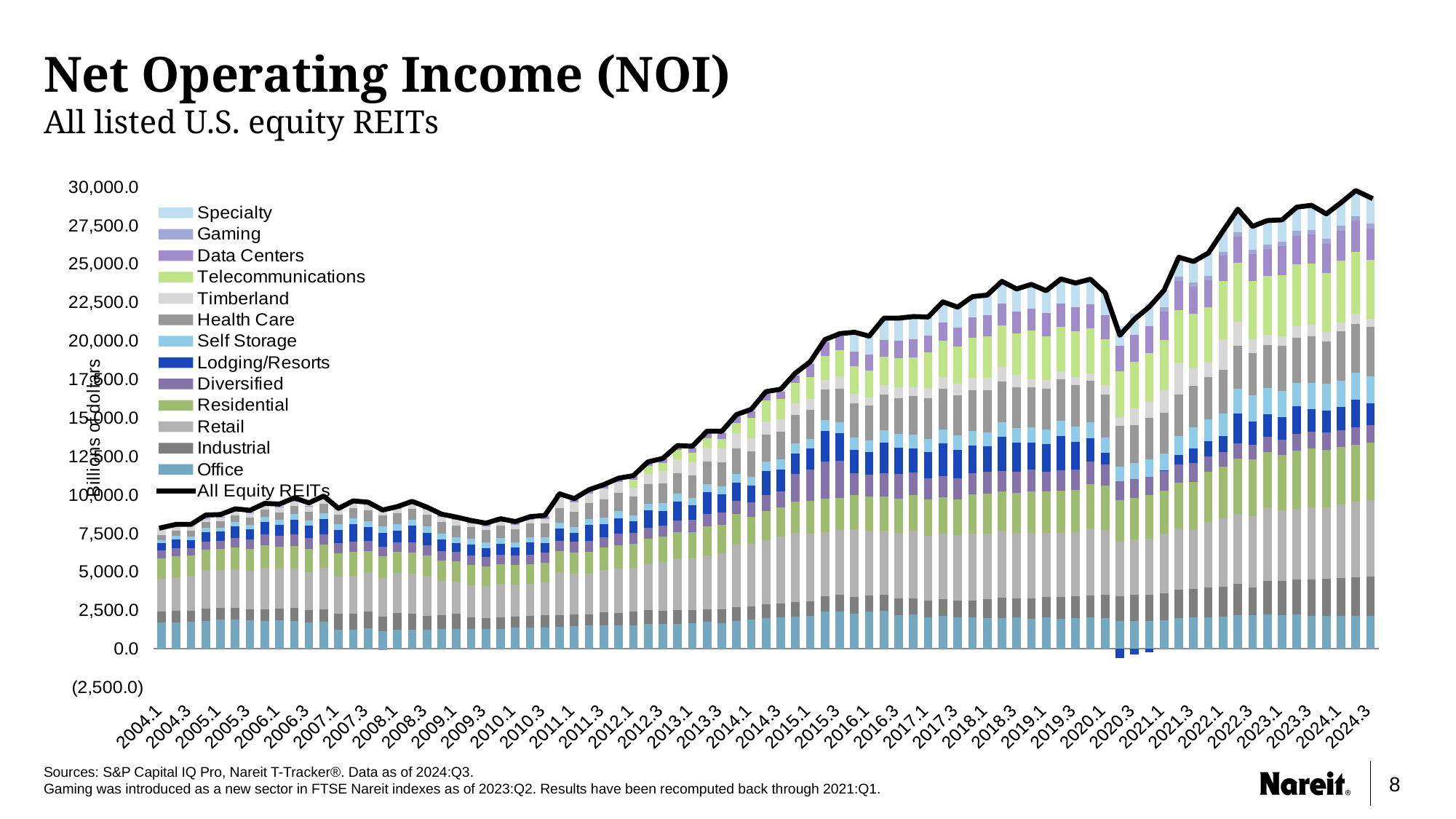
Which is larger, the All Equity REITs value for 2022.3 or for 2020.3? 2022.3 Is the value for Lodging/Resorts in 2020.3 greater or less than 0? less How many entries does the legend list? 14 What kind of chart is shown on the slide? Stacked bar chart with a line overlay Is the All Equity REITs value for 2024.3 greater or less than 27,500? greater What is the title of the chart on the slide? Net Operating Income (NOI) Is the All Equity REITs value for 2004.1 greater or less than 10,000? less Which is larger, the All Equity REITs value for 2015.3 or for 2009.3? 2015.3 What is the label on the vertical axis? Billions of dollars Overall, does the All Equity REITs line rise or fall from 2004.1 to 2024.3? rise